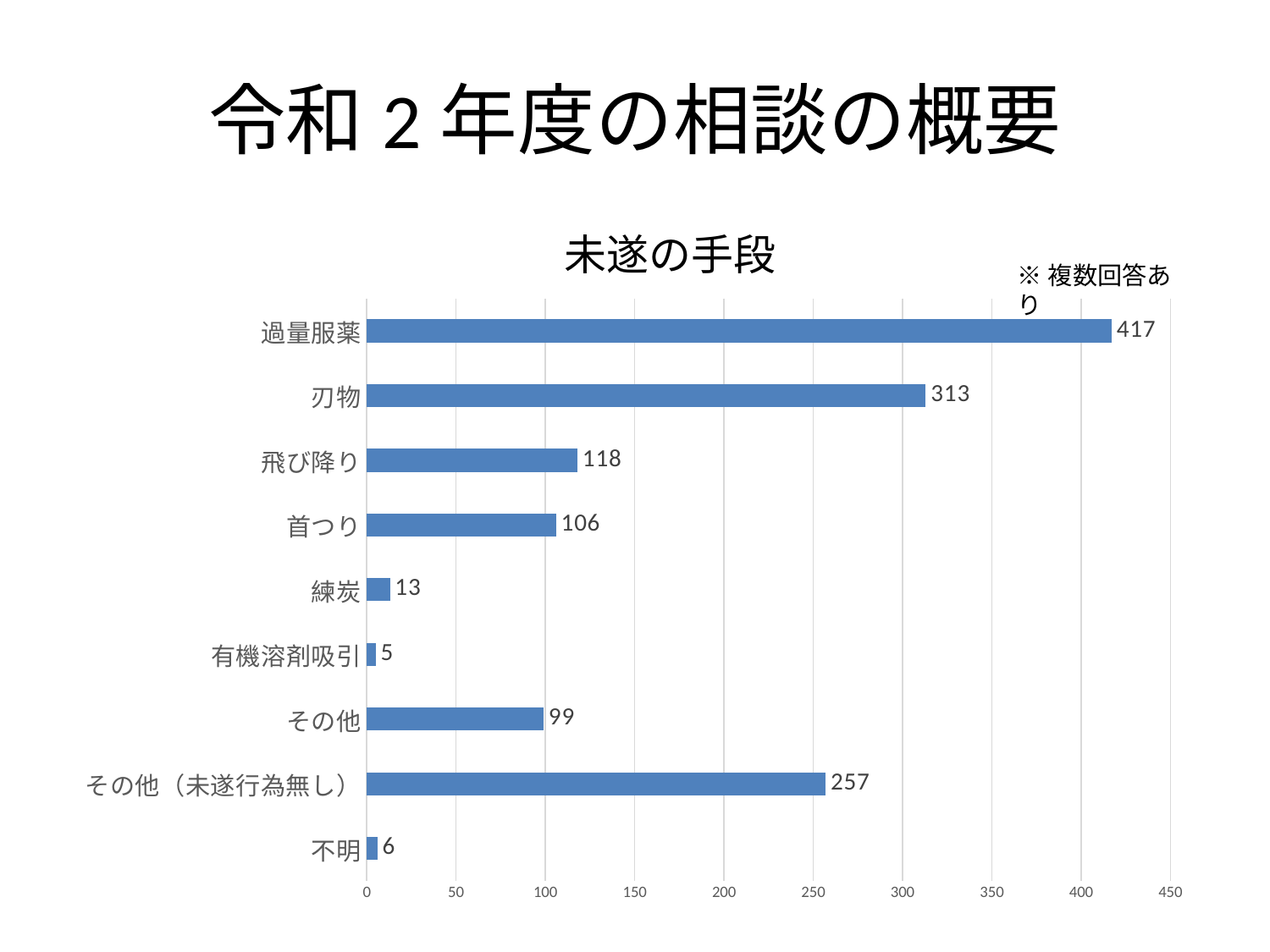
What kind of chart is shown on the slide? bar chart Which category has the highest value? 過量服薬 What is the value for 有機溶剤吸引? 5 What is the difference between the values for 過量服薬 and 刃物? 104 Which is larger, the value for 飛び降り or the value for 首つり? 飛び降り What is the value for 過量服薬? 417 What is the value for その他（未遂行為無し）? 257 What is the title of the chart? 未遂の手段 Is the value for その他（未遂行為無し） greater or less than 250? greater Which category has the lowest value? 有機溶剤吸引 How many categories are shown in the chart? 9 What is the value for 刃物? 313